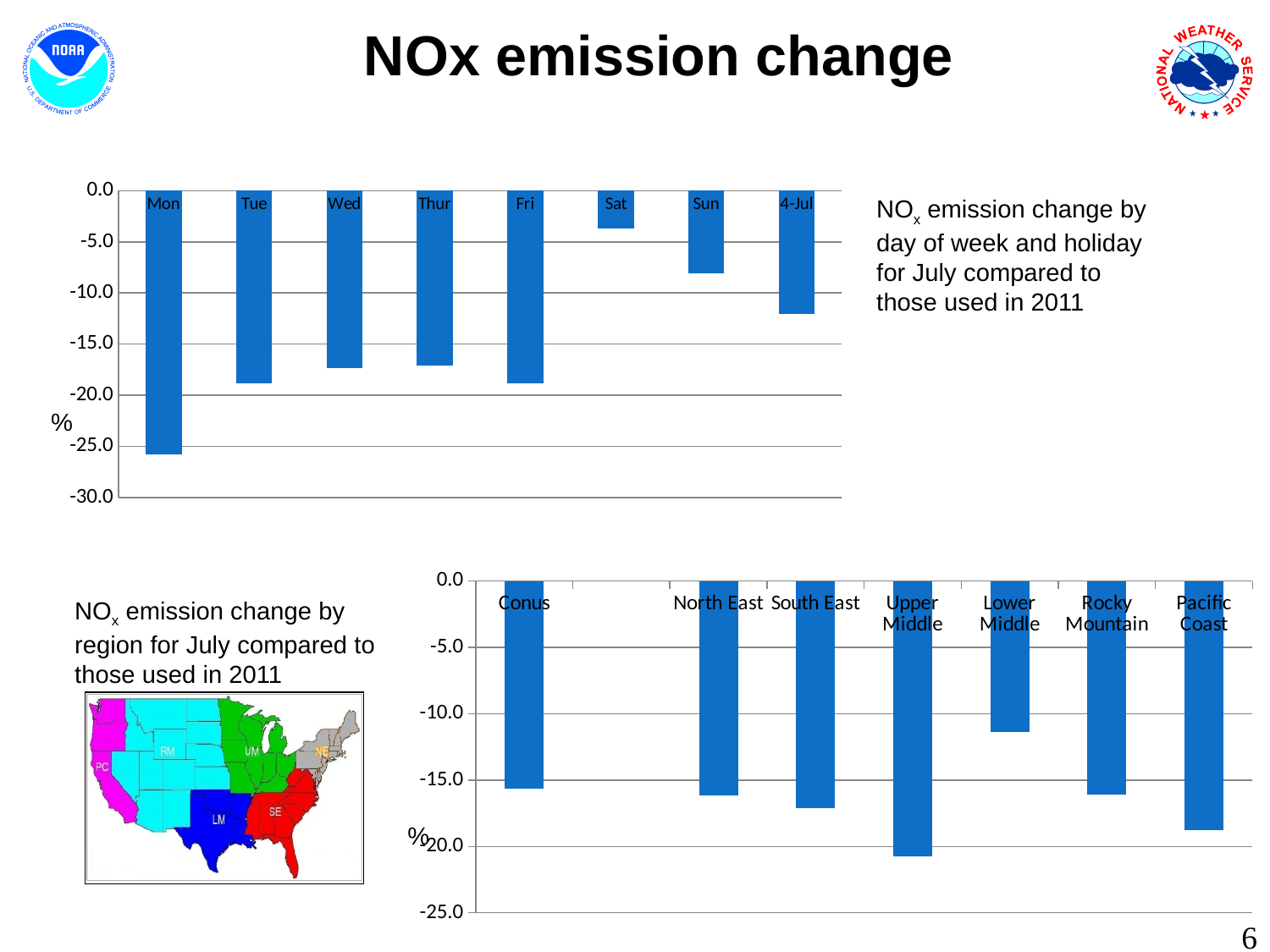
In the bottom chart (by region), which region has the smallest NOx emission change (the bar closest to zero)? Lower Middle In the bottom chart (by region), is the value for Pacific Coast greater or less than -15.0? less In the top chart (by day of week), is the value for Sat greater or less than -5.0? greater How many categories are shown in the top chart (by day of week)? 8 In the top chart (by day of week), which category has the smallest NOx emission change (the bar closest to zero)? Sat In the bottom chart (by region), which region has the largest NOx emission decrease (the most negative value)? Upper Middle In the top chart (by day of week), which category has the largest NOx emission decrease (the most negative value)? Mon In the top chart (by day of week), is the value for 4-Jul greater or less than -10.0? less How many regions are shown in the bottom chart (by region)? 7 What kind of chart is the bottom chart (by region)? bar chart In the top chart (by day of week), which has the more negative value, Sun or 4-Jul? 4-Jul